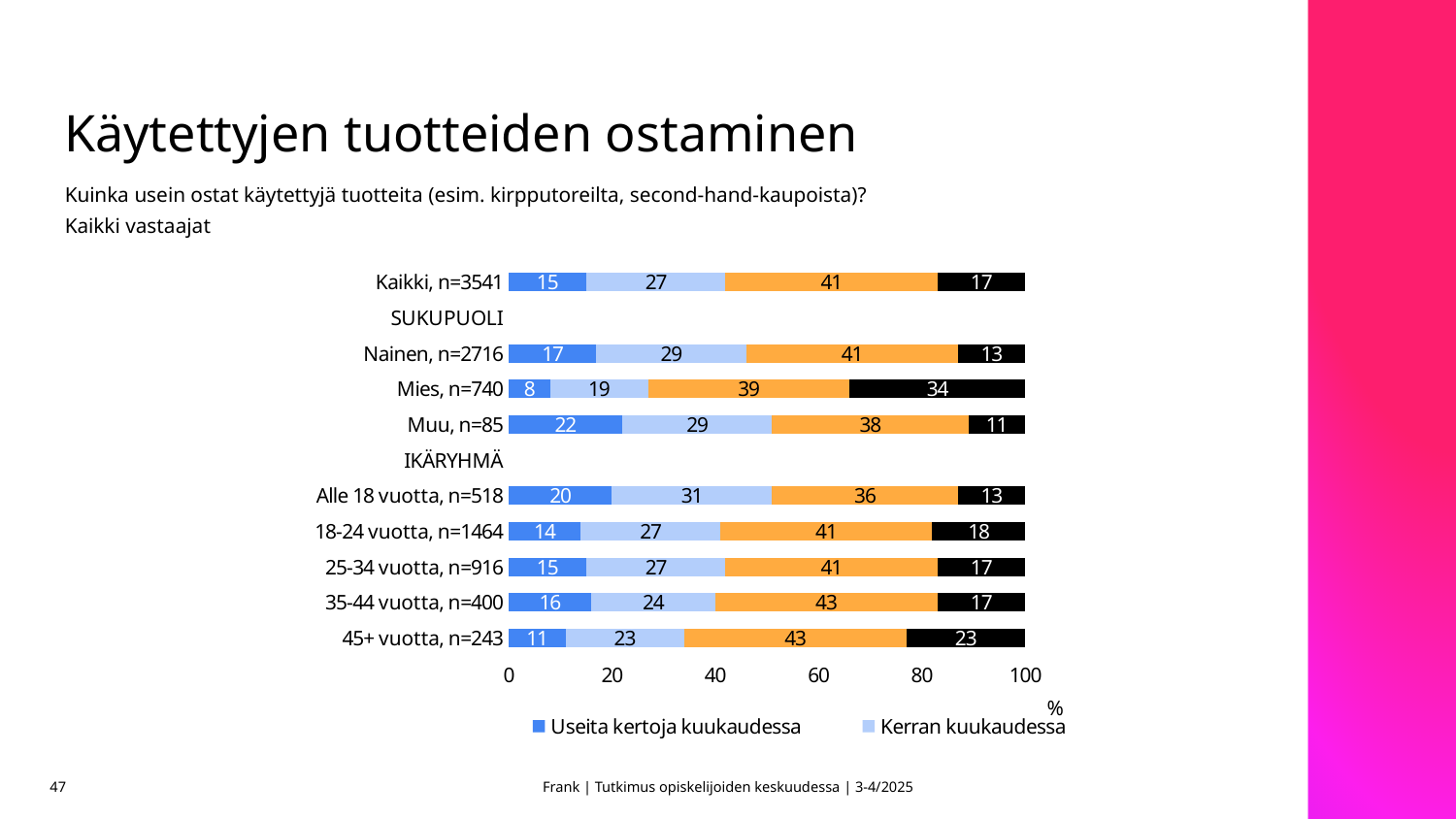
What is the difference between the "Kerran kuukaudessa" values for Nainen, n=2716 and Mies, n=740? 10 What is the value of the black segment for Mies, n=740? 34 What is the value of "Useita kertoja kuukaudessa" for Mies, n=740? 8 What is the title of the slide? Käytettyjen tuotteiden ostaminen Which group has the highest value for "Useita kertoja kuukaudessa"? Muu, n=85 What is the value of "Kerran kuukaudessa" for Alle 18 vuotta, n=518? 31 How many groups (bars) are plotted in the chart? 9 Which group has the lowest value for "Useita kertoja kuukaudessa"? Mies, n=740 Which has the larger "Useita kertoja kuukaudessa" value: 35-44 vuotta, n=400 or 45+ vuotta, n=243? 35-44 vuotta, n=400 What is the value of "Kerran kuukaudessa" for 45+ vuotta, n=243? 23 What kind of chart is shown on the slide? Stacked horizontal bar chart What is the total of the stacked bar for Kaikki, n=3541? 100